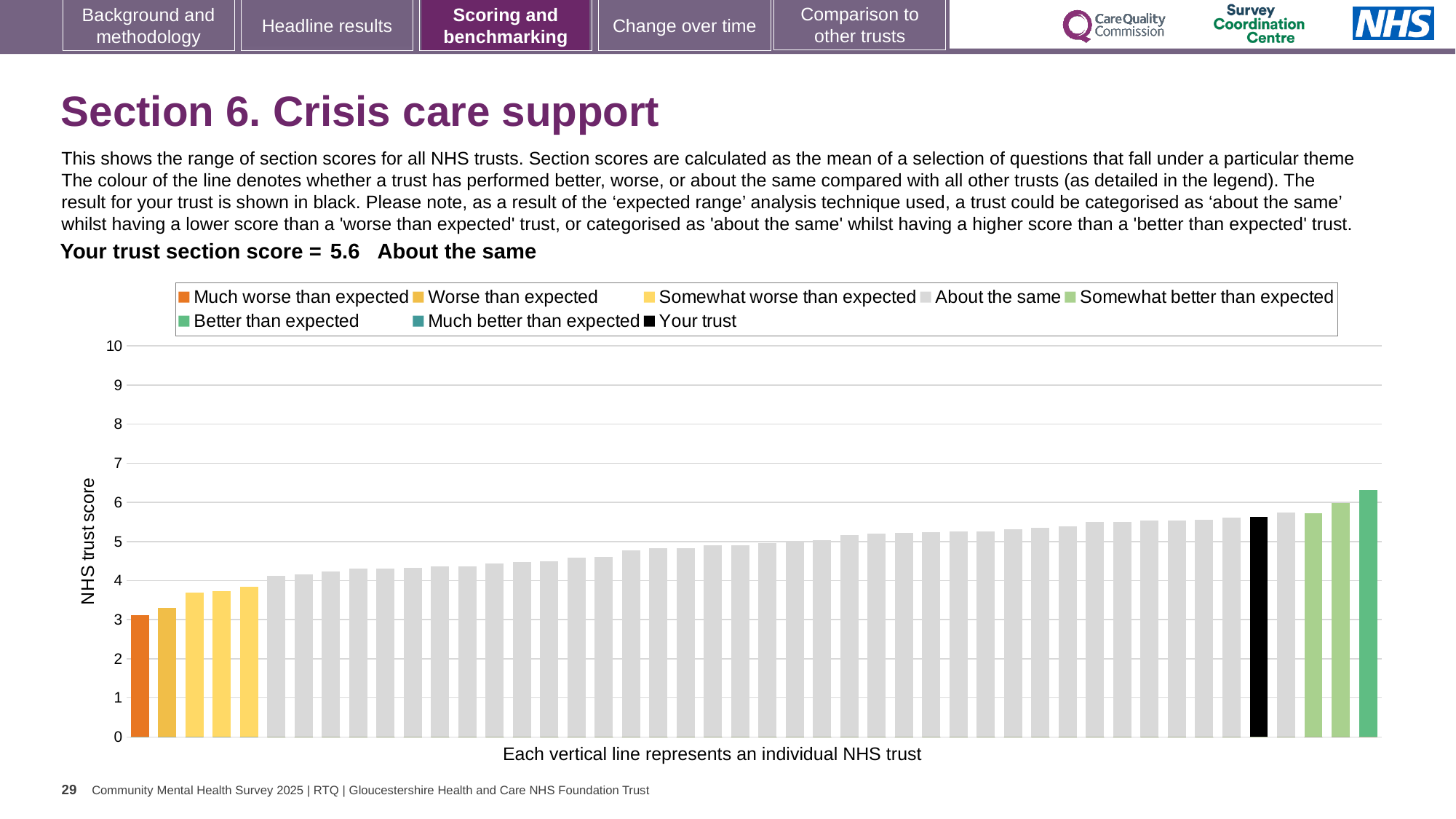
Which legend category does the highest bar on the chart belong to? Better than expected Is the value of the lowest bar (the 'Much worse than expected' trust) greater or less than 4? less How many entries does the chart legend list? 8 Is the value of the bar for your trust greater or less than 5? greater Is the value of the highest bar (the 'Better than expected' trust) greater or less than 6? greater What is the label on the vertical axis of the chart? NHS trust score How many bars on the chart are coloured as 'Somewhat better than expected'? 2 Which legend category does the lowest bar on the chart belong to? Much worse than expected What is the section score for your trust shown on the slide? 5.6 Do the bar values rise or fall from left to right along the x axis? rise What kind of chart is shown on the slide? bar chart What colour is used for the bar representing your trust? black